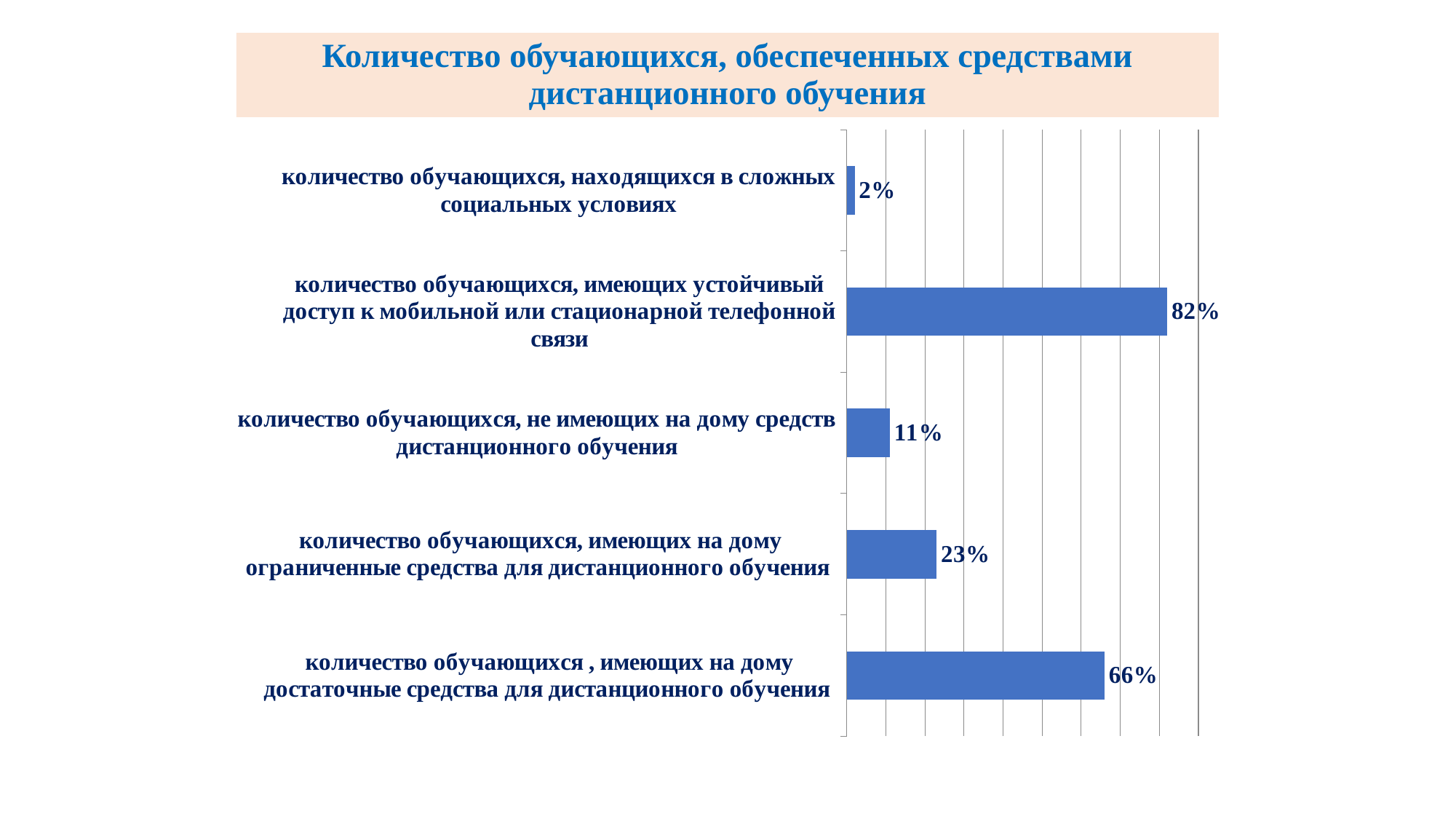
Which category has the lowest value? количество обучающихся, находящихся в сложных социальных условиях What is the value for the category 'количество обучающихся, имеющих на дому достаточные средства для дистанционного обучения'? 66% What is the title of the chart? Количество обучающихся, обеспеченных средствами дистанционного обучения What kind of chart is shown on the slide? Bar chart Which is larger: the value for students with limited means for distance learning at home (ограниченные средства) or the value for students with no means for distance learning at home (не имеющих средств)? ограниченные средства (23%) Which category has the highest value? количество обучающихся, имеющих устойчивый доступ к мобильной или стационарной телефонной связи What is the value for the category 'количество обучающихся, не имеющих на дому средств дистанционного обучения'? 11% How many categories are shown in the chart? 5 What is the value for the category 'количество обучающихся, находящихся в сложных социальных условиях'? 2% What is the difference between the value for students with stable phone access (82%) and the value for students with sufficient means for distance learning at home (66%)? 16% What is the value for the category 'количество обучающихся, имеющих устойчивый доступ к мобильной или стационарной телефонной связи'? 82% What is the difference between the value for students with sufficient means for distance learning at home (достаточные средства) and the value for students with limited means (ограниченные средства)? 43%